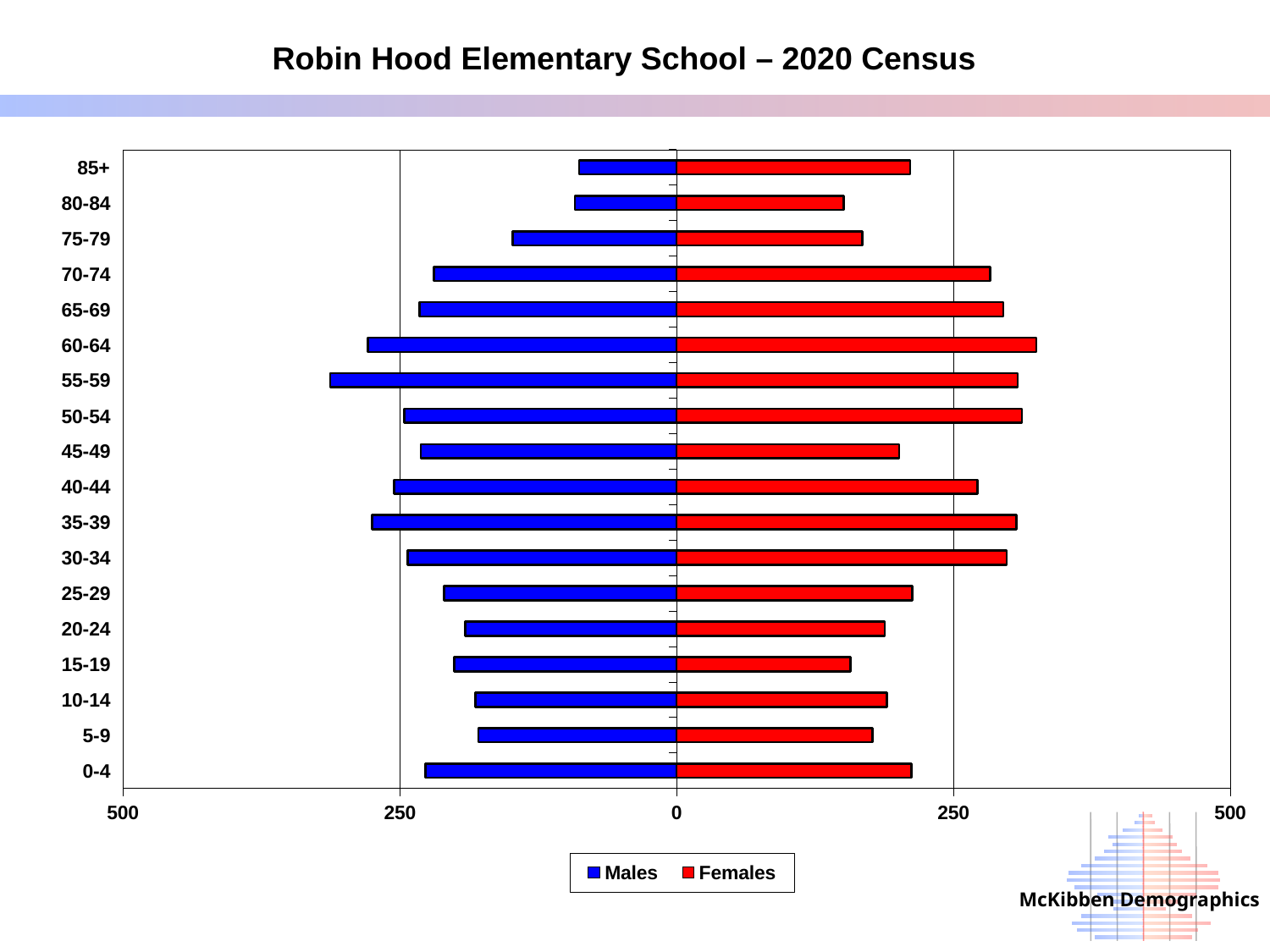
How many age groups are plotted on the chart? 18 Is the Males value for the 55-59 age group greater or less than 250? greater Is the Females value for the 60-64 age group greater or less than 250? greater What kind of chart is shown on the slide? Bar chart What colour represents Females in the chart? Red Is the Females value for the 45-49 age group greater or less than 250? less Which age group has the highest value for Males? 55-59 How many series does the legend list? 2 Which age group has the highest value for Females? 60-64 For the 85+ age group, which is larger, the Males value or the Females value? Females Which is larger, the Males value for 55-59 or the Males value for 0-4? 55-59